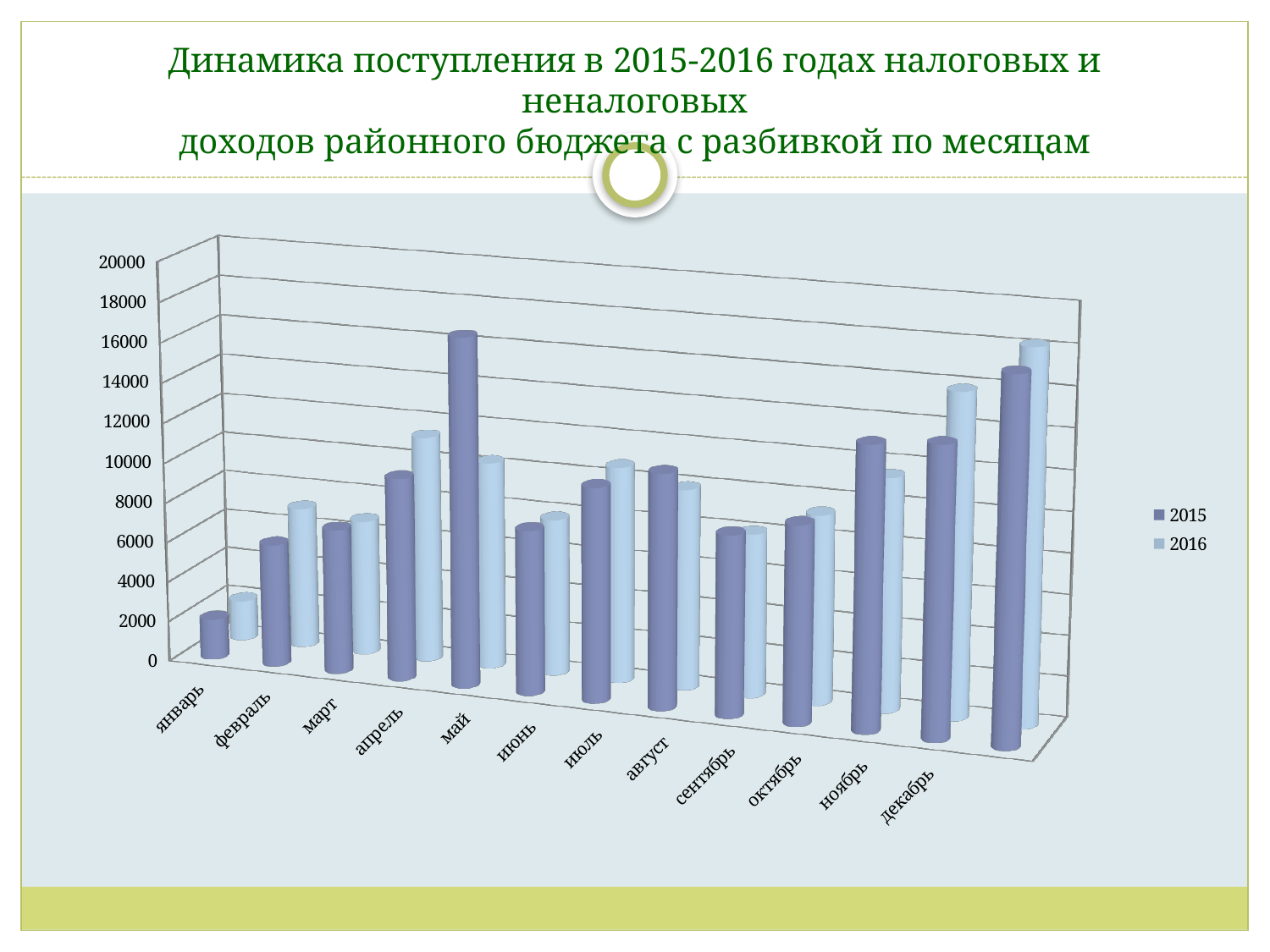
Is the value for май in the 2015 series greater or less than 14000? greater For апрель, which series has the larger value, 2015 or 2016? 2016 Which month has the highest value for the 2015 series? май How many months (categories) are shown on the x axis? 12 For май, which series has the larger value, 2015 or 2016? 2015 What are the two entries listed in the chart legend? 2015 and 2016 What kind of chart is shown on the slide? bar chart Which month has the lowest value for the 2016 series? январь Which month has the lowest value for the 2015 series? январь Is the value for январь in the 2015 series greater or less than 4000? less How many series does the legend list? 2 Which month has the highest value for the 2016 series? декабрь